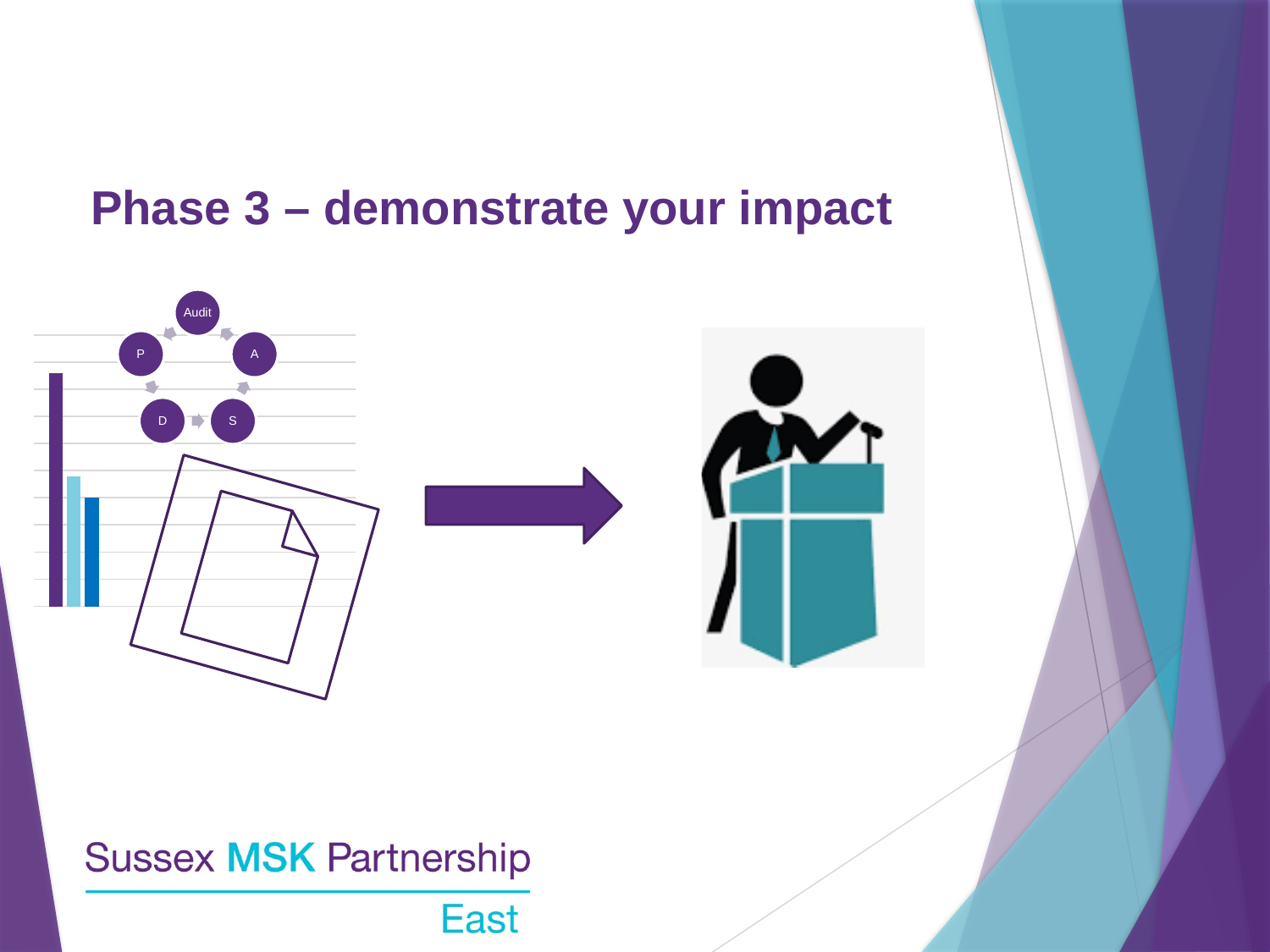
In the chart on the left side of the slide, which bar is the shortest? the dark blue bar How many bars does the chart on the left side of the slide show? 3 What kind of chart is shown on the left side of the slide? bar chart In the chart on the left side of the slide, which bar is the tallest? the purple bar